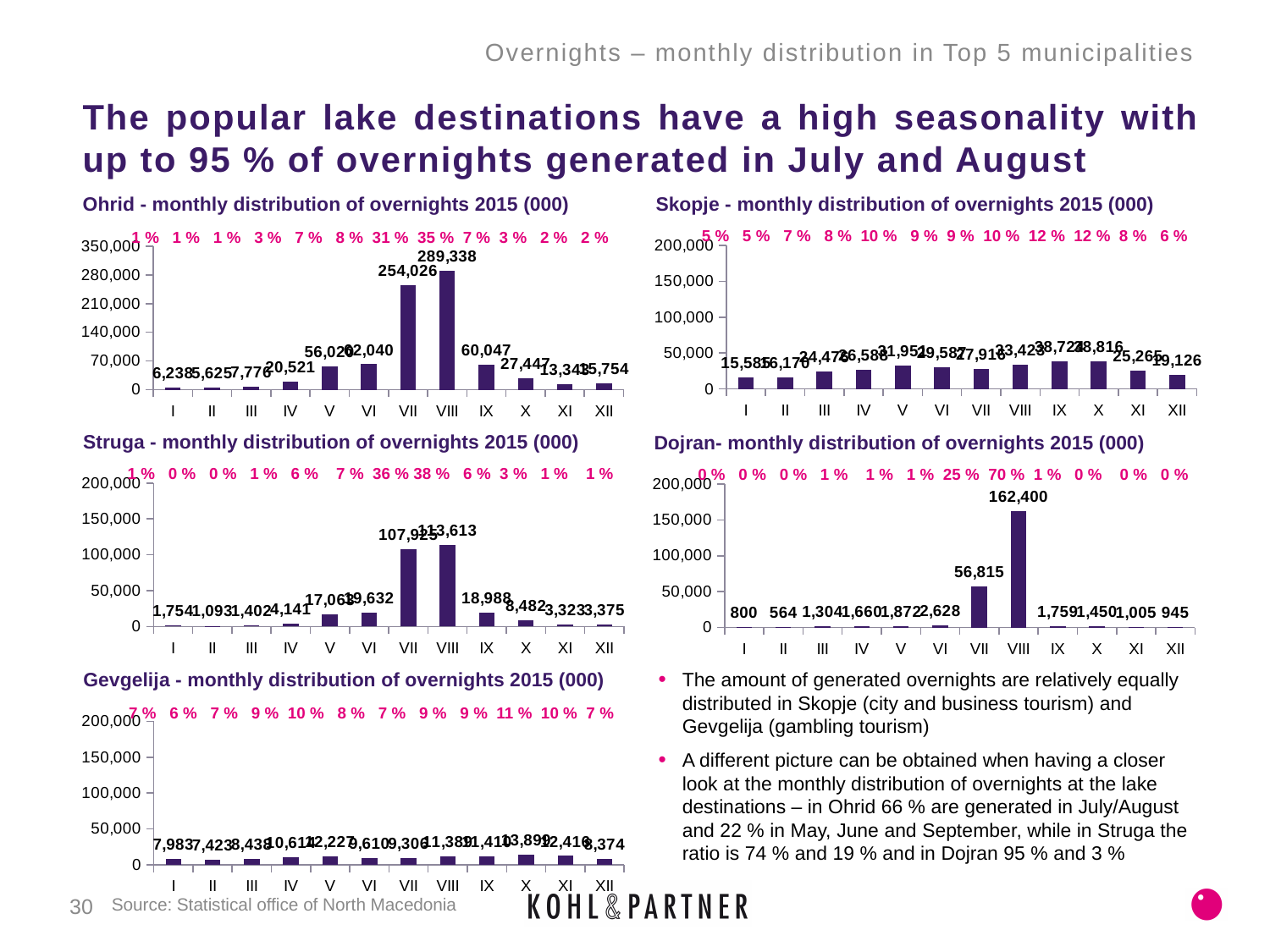
What kind of chart is the Dojran chart? bar chart In the Dojran chart, what is the difference between the values for month VIII and month VII? 105,585 In the Dojran chart, what is the value for month VIII? 162,400 In the Dojran chart, what is the value for month VII? 56,815 In the Ohrid chart, what is the value for month VII? 254,026 In the Ohrid chart, which month has the highest value? VIII In the Dojran chart, what is the value for month I? 800 In the Skopje chart, is the value for month IX greater or less than 50,000? less In the Ohrid chart, what is the difference between the values for month VIII and month VII? 35,312 How many months are shown on the x axis of the Gevgelija chart? 12 In the Struga chart, which month has the highest value? VIII In the Ohrid chart, what is the value for month VIII? 289,338